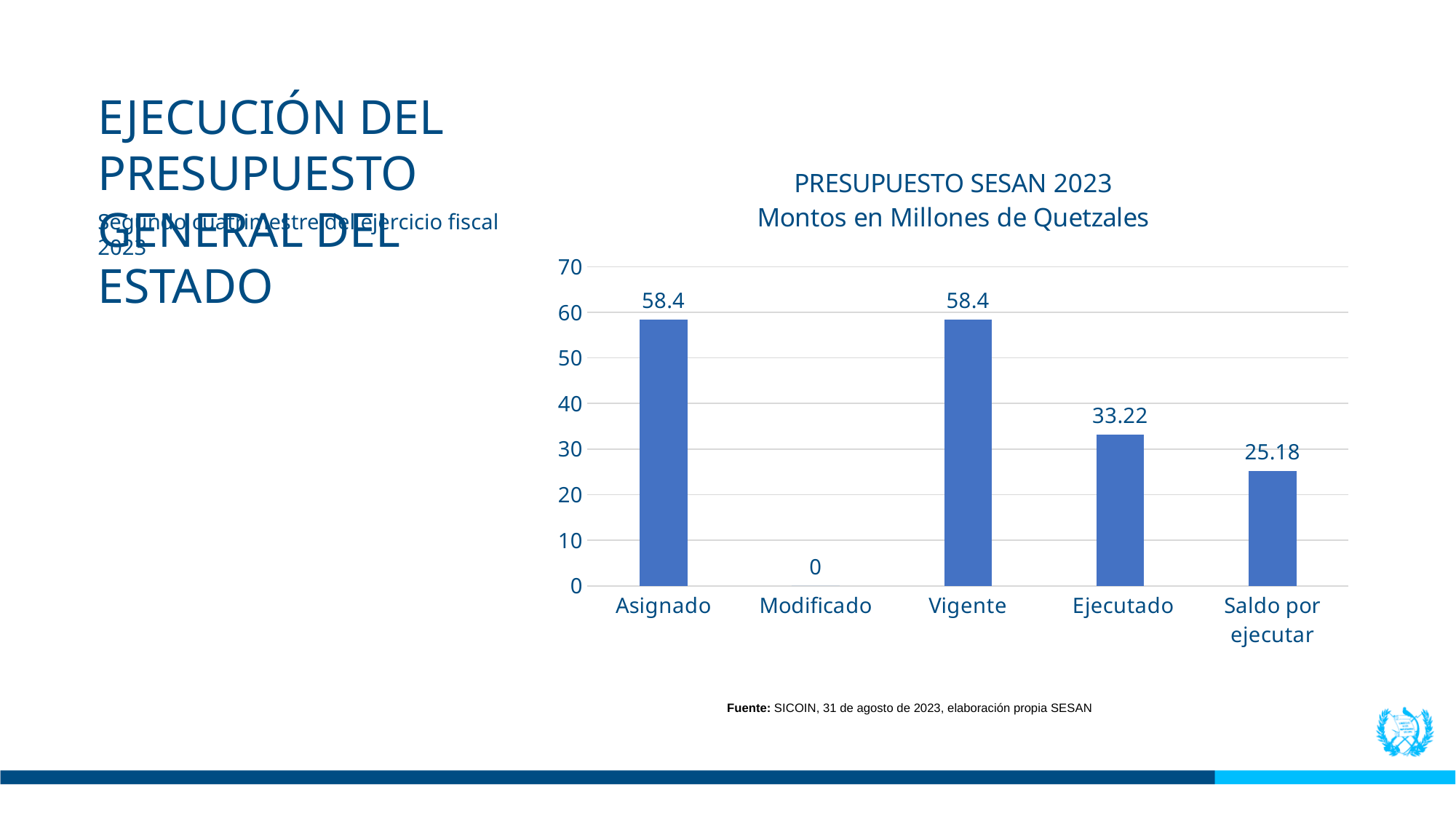
What kind of chart is shown on the slide? bar chart What is the value for Ejecutado? 33.22 What is the difference between Vigente and Ejecutado? 25.18 Which category has the lowest value? Modificado Which is larger, Ejecutado or Saldo por ejecutar? Ejecutado What is the difference between Ejecutado and Saldo por ejecutar? 8.04 What is the value for Asignado? 58.4 What is the value for Saldo por ejecutar? 25.18 Is the value for Ejecutado greater or less than 30? greater What is the value for Modificado? 0 How many categories are shown on the x axis? 5 What is the title of the chart? PRESUPUESTO SESAN 2023 Montos en Millones de Quetzales